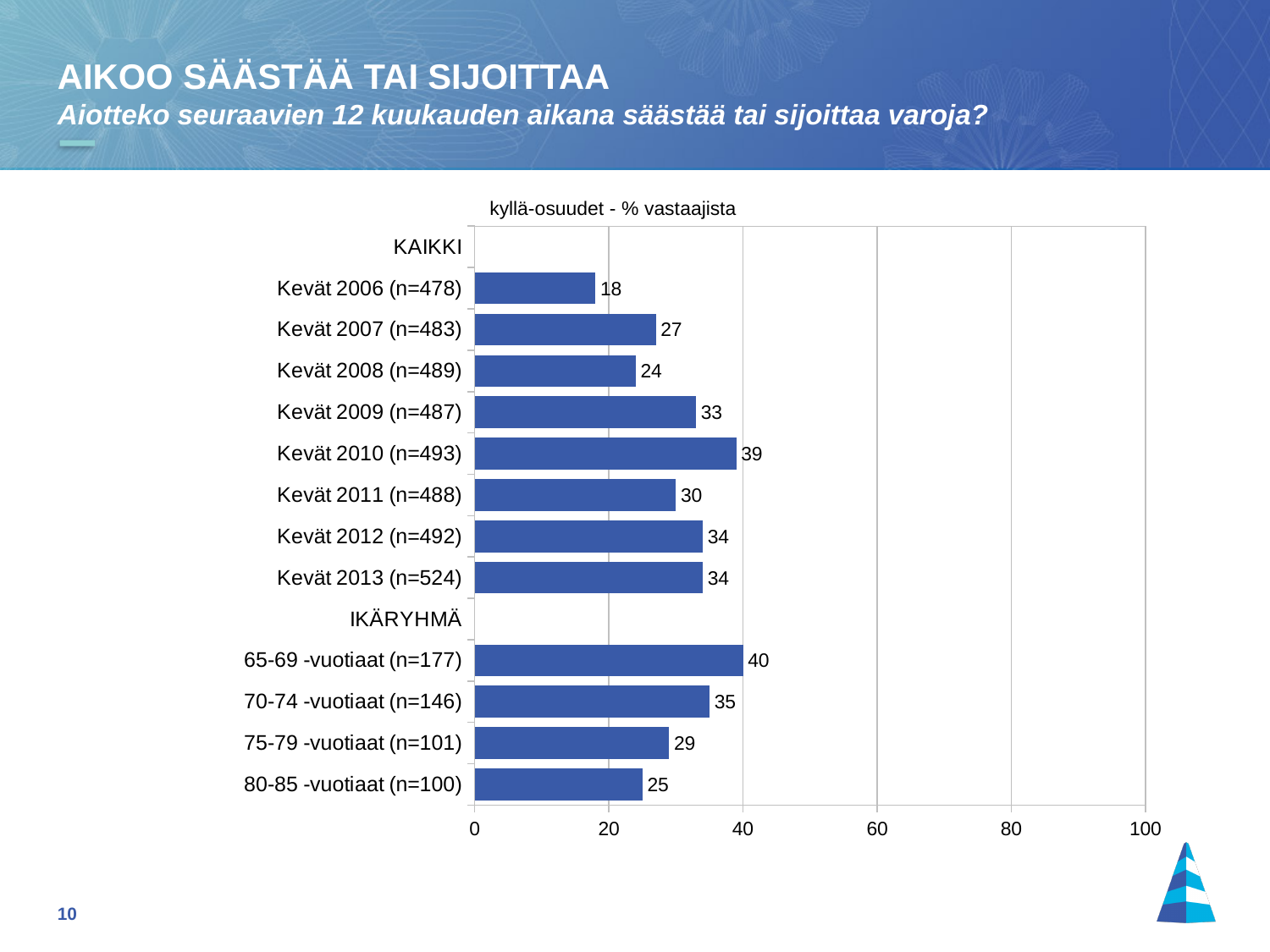
Do the values for the age groups rise or fall from 65-69 -vuotiaat to 80-85 -vuotiaat? fall What is the value for Kevät 2006 (n=478)? 18 Which category has the lowest value in the chart? Kevät 2006 (n=478) What is the value for Kevät 2010 (n=493)? 39 Is the value for 70-74 -vuotiaat (n=146) greater or less than 20? greater How many bars with data values are plotted in the chart? 12 What is the difference between the values for Kevät 2010 (n=493) and Kevät 2011 (n=488)? 9 Which is larger, the value for Kevät 2007 (n=483) or Kevät 2008 (n=489)? Kevät 2007 (n=483) What is the value for 80-85 -vuotiaat (n=100)? 25 What kind of chart is shown on the slide? bar chart Which category has the highest value in the chart? 65-69 -vuotiaat (n=177) What is the title shown above the chart? kyllä-osuudet - % vastaajista